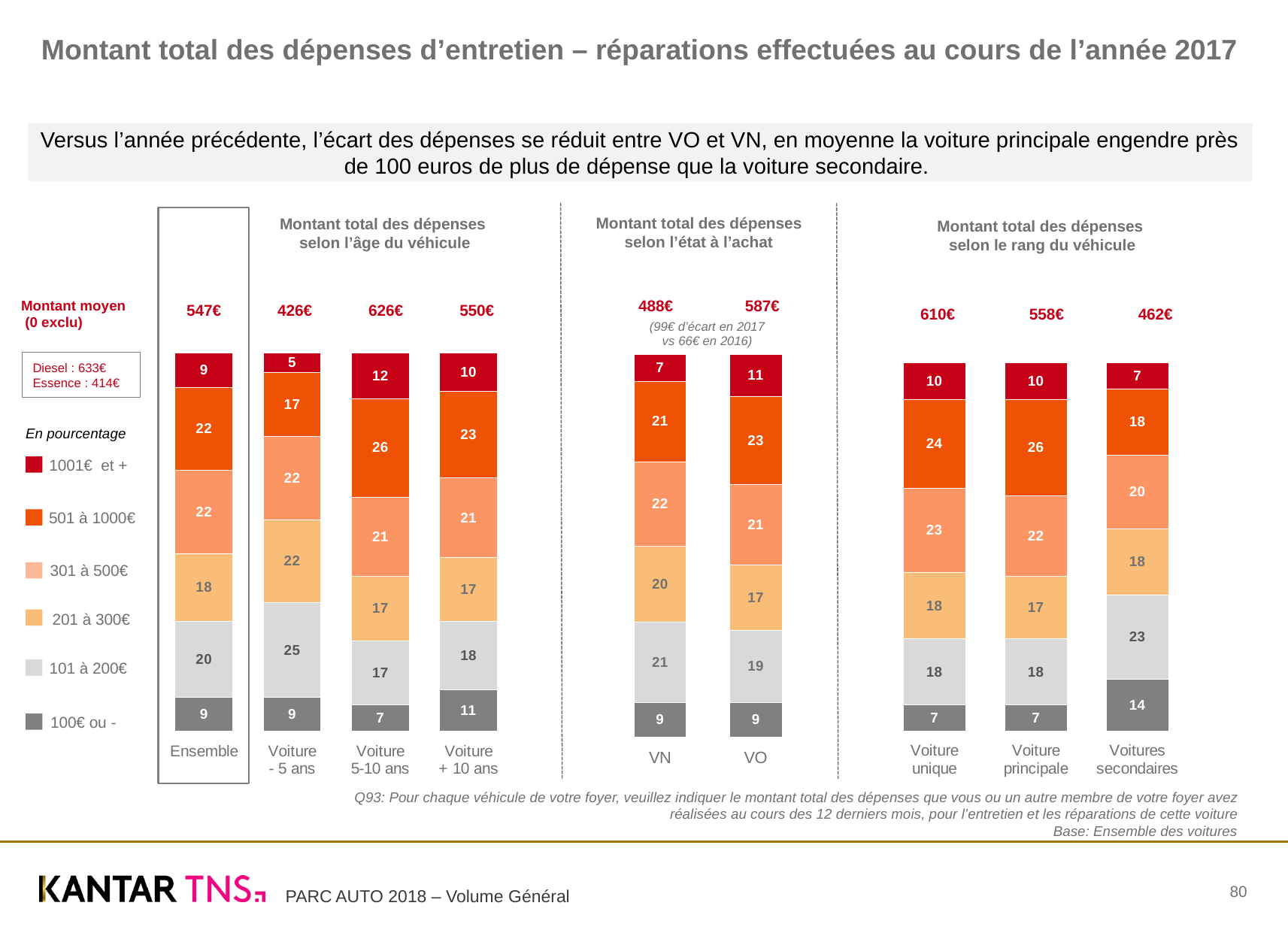
What type of chart is used to show the spending distribution for 'Ensemble'? Stacked bar chart How many vehicle categories are shown in the chart 'Montant total des dépenses selon le rang du véhicule'? 3 In the chart 'Montant total des dépenses selon le rang du véhicule', what is the difference in the '101 à 200€' share between 'Voitures secondaires' and 'Voiture unique'? 5 How many spending bands does the legend list for the stacked bars? 6 In the chart 'Montant total des dépenses selon l'âge du véhicule', which vehicle age category has the highest average amount (Montant moyen)? Voiture 5-10 ans In the chart 'Montant total des dépenses selon l'état à l'achat', what is the difference between the average amounts for VO and VN? 99€ In the chart 'Montant total des dépenses selon le rang du véhicule', which category has the lowest average amount (Montant moyen)? Voitures secondaires In the chart 'Montant total des dépenses selon l'âge du véhicule', which has a larger share in the '1001€ et +' band: 'Voiture - 5 ans' or 'Voiture + 10 ans'? Voiture + 10 ans What is the average amount (Montant moyen) shown for 'Ensemble'? 547€ In the chart 'Montant total des dépenses selon le rang du véhicule', what percentage of 'Voitures secondaires' falls in the '100€ ou -' band? 14 In the chart 'Montant total des dépenses selon l'âge du véhicule', what percentage of 'Voiture 5-10 ans' falls in the '501 à 1000€' band? 26 In the chart 'Montant total des dépenses selon l'état à l'achat', what is the average amount (Montant moyen) shown for VO? 587€